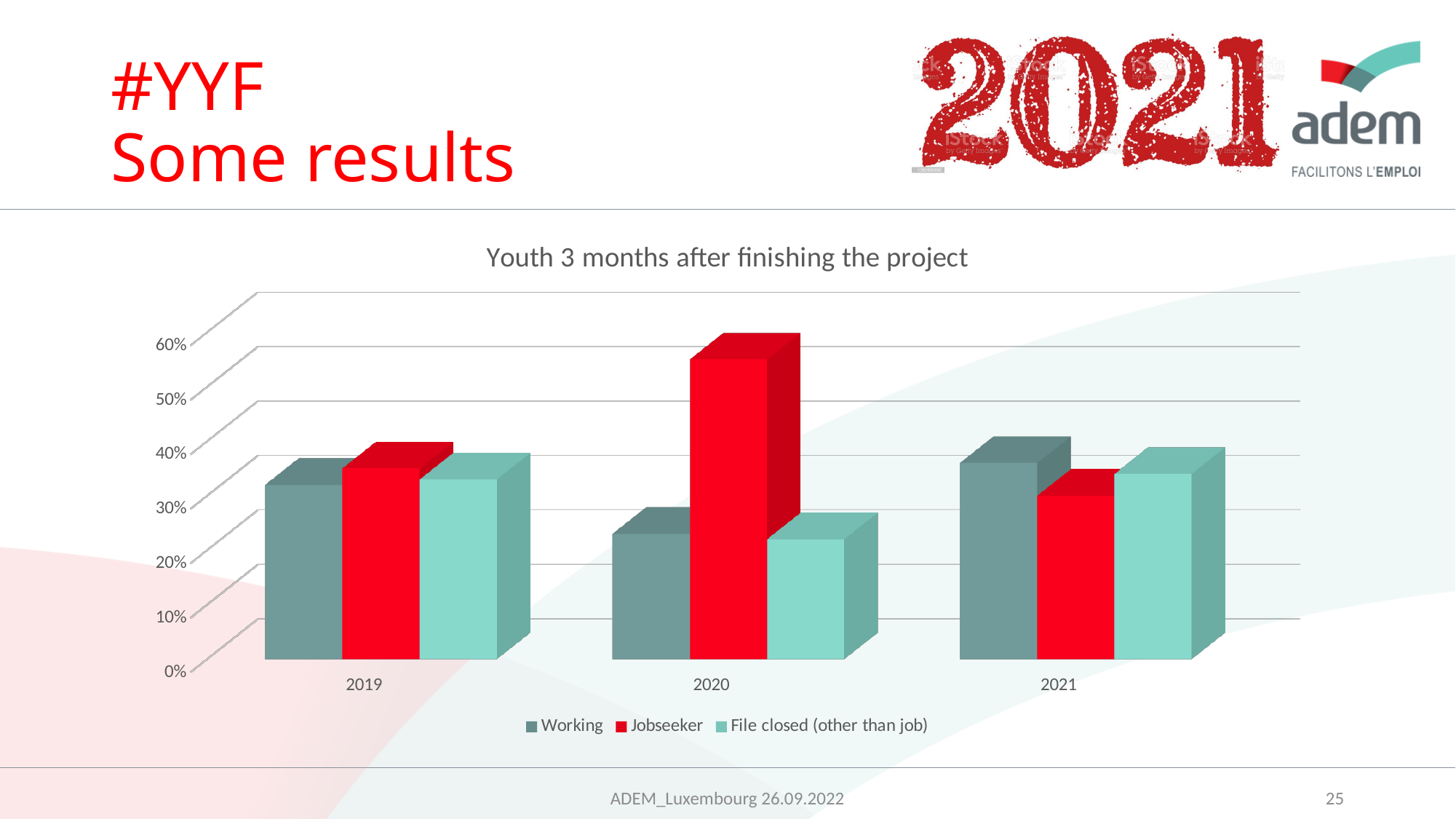
What kind of chart is shown on the slide? bar chart What is the title of the chart? Youth 3 months after finishing the project Is the value for Jobseeker in 2020 greater or less than 50%? greater Does the Jobseeker value rise or fall from 2020 to 2021? fall Is the value for Working in 2020 greater or less than 40%? less Which series is shown in red? Jobseeker How many series does the legend list? 3 How many year categories are shown on the x axis? 3 Which series has the highest value in 2020? Jobseeker In 2021, which is larger: Working or Jobseeker? Working Is the value for Working in 2021 greater or less than 30%? greater